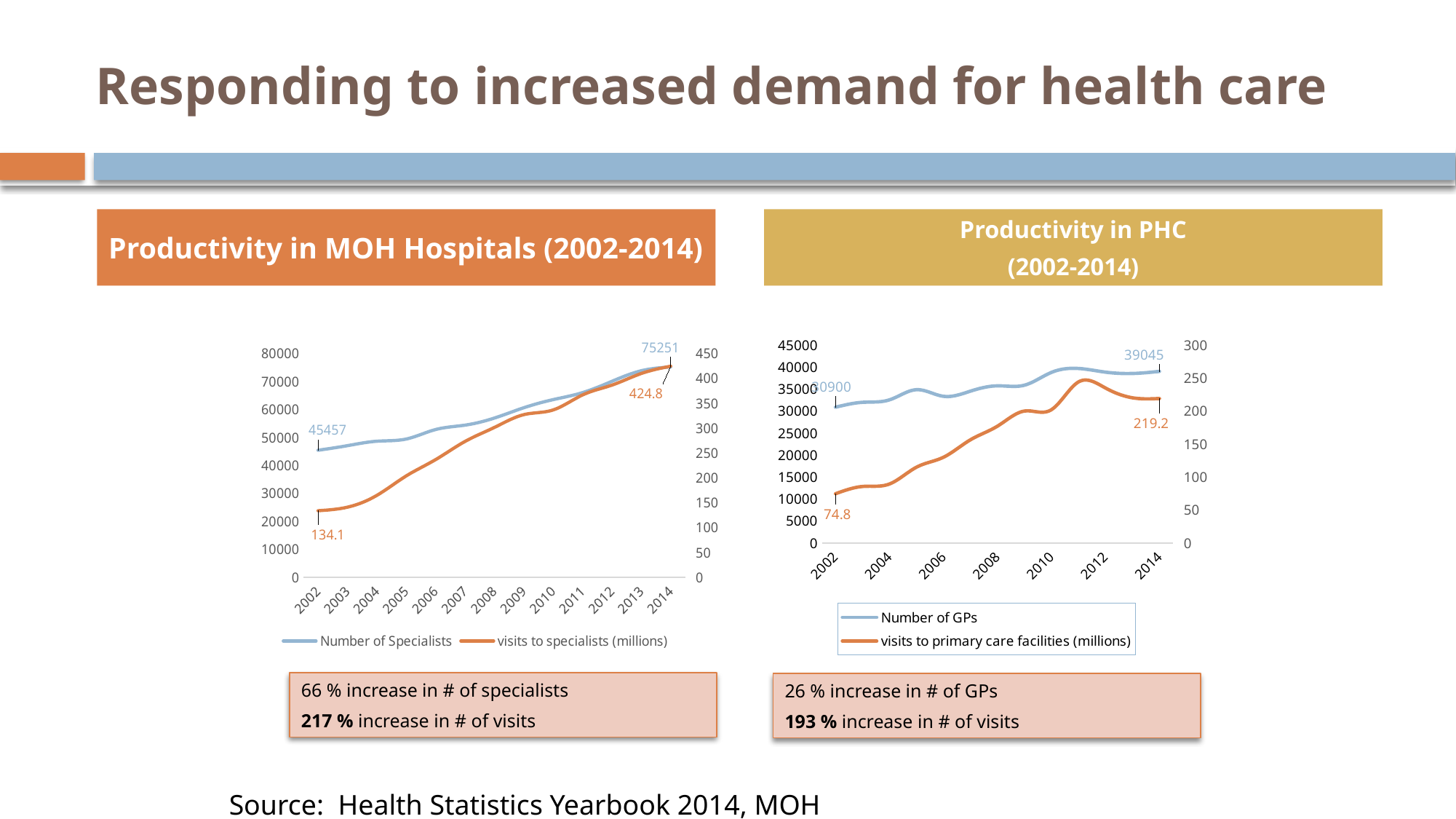
In the Productivity in MOH Hospitals chart, by how much did the Number of Specialists increase from 2002 to 2014? 29794 How many series does the legend of the Productivity in PHC chart list? 2 In the Productivity in MOH Hospitals chart, is the Number of Specialists in 2002 larger or smaller than in 2014? smaller What type of chart is the Productivity in MOH Hospitals chart? line chart In the Productivity in MOH Hospitals chart, what is the value of visits to specialists (millions) in 2002? 134.1 In the Productivity in PHC chart, what is the value of visits to primary care facilities (millions) in 2014? 219.2 In the Productivity in PHC chart, is the value of visits to primary care facilities (millions) in 2004 greater or less than 150? less In the Productivity in MOH Hospitals chart, does the Number of Specialists rise or fall from 2002 to 2014? rise In the Productivity in PHC chart, what is the difference between visits to primary care facilities (millions) in 2014 and in 2002? 144.4 In the Productivity in PHC chart, what is the Number of GPs in 2014? 39045 In the Productivity in MOH Hospitals chart, is the Number of Specialists in 2008 greater or less than 50000? greater In the Productivity in MOH Hospitals chart, what is the Number of Specialists in 2014? 75251